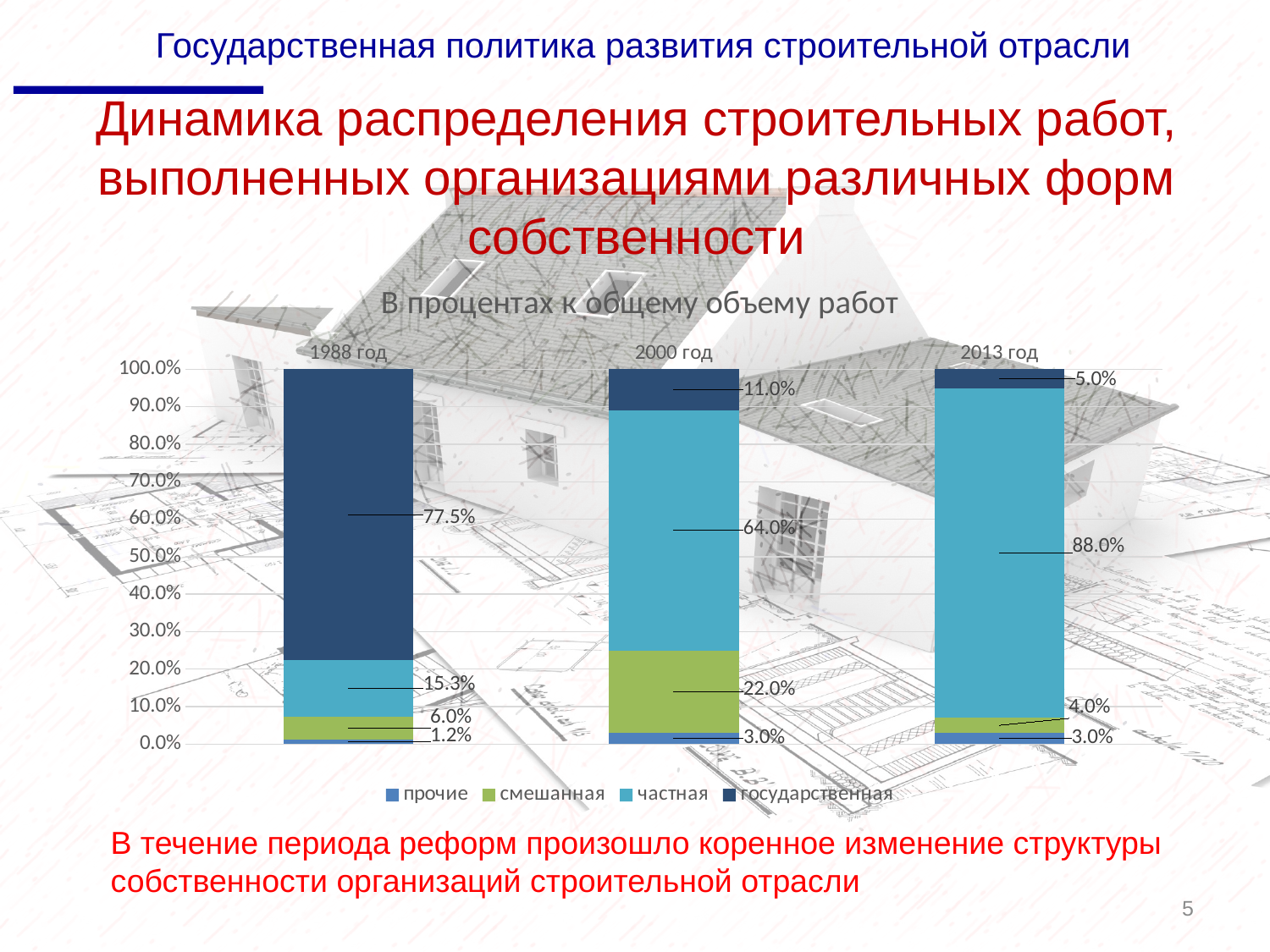
How many series does the legend list? 4 What is the difference between the частная values for 2013 год and 2000 год? 24.0% How many years are shown on the x axis? 3 What kind of chart is shown on the slide? stacked bar chart Which is larger: смешанная in 2000 год or смешанная in 2013 год? смешанная in 2000 год In which year is the value for государственная the lowest? 2013 год What is the value for государственная in 1988 год? 77.5% What is the value for государственная in 2013 год? 5.0% In which year is the value for частная the highest? 2013 год What is the value for прочие in 1988 год? 1.2% What is the value for смешанная in 2000 год? 22.0% What is the value for частная in 2013 год? 88.0%